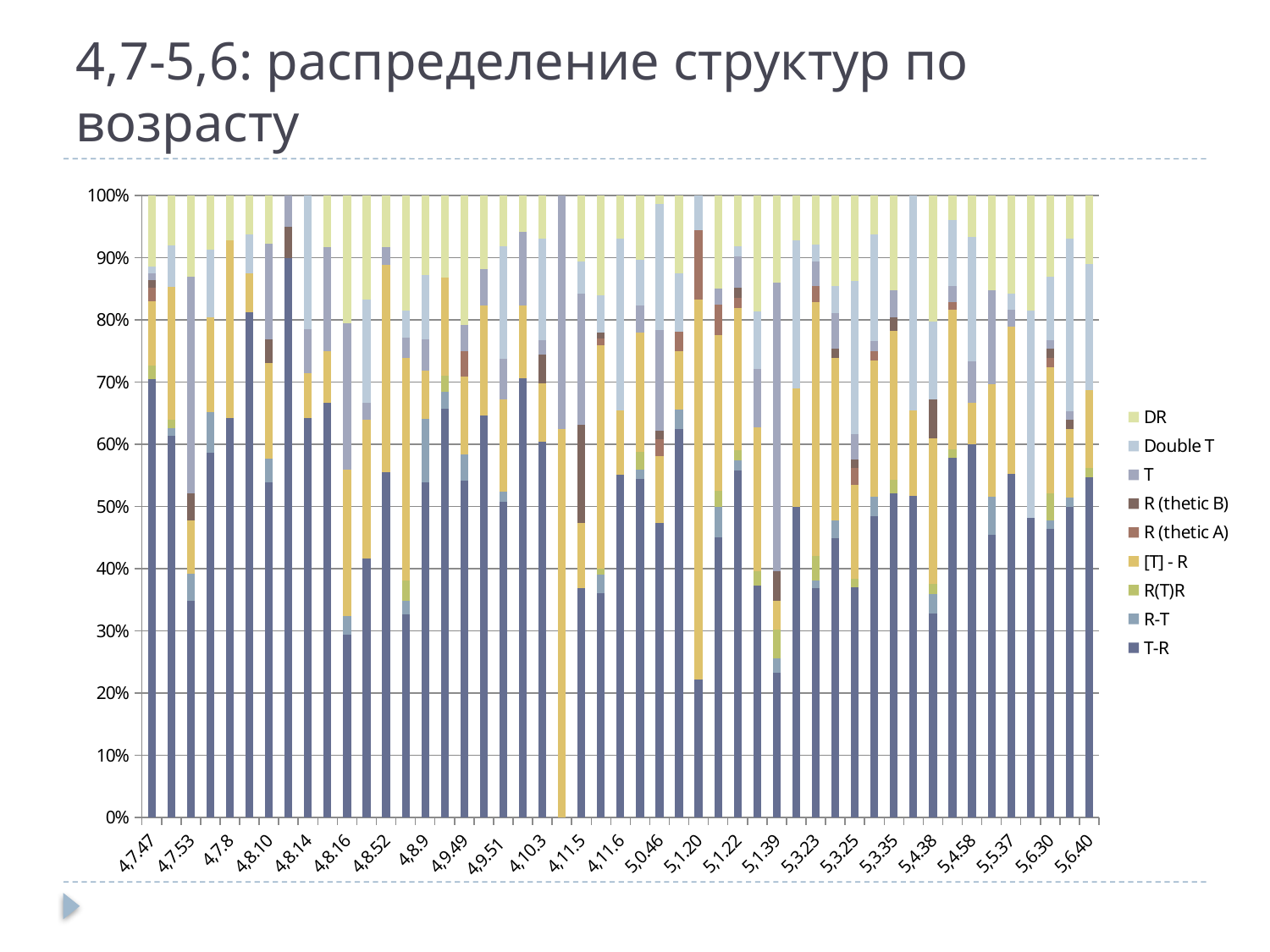
What is the first category label on the x axis? 4,7.47 How many series does the legend list? 9 What is the last category label on the x axis? 5,6.40 Is the T-R share for 4,7.47 greater or less than 60%? greater What is the title of the chart on the slide? 4,7-5,6: распределение структур по возрасту Is the T-R share for 5,6.40 greater or less than 70%? less What kind of chart is shown on the slide? stacked bar chart Which series is listed at the bottom of the legend? T-R Is the T-R share for 5,6.40 greater or less than 40%? greater What is the maximum value shown on the vertical axis? 100%